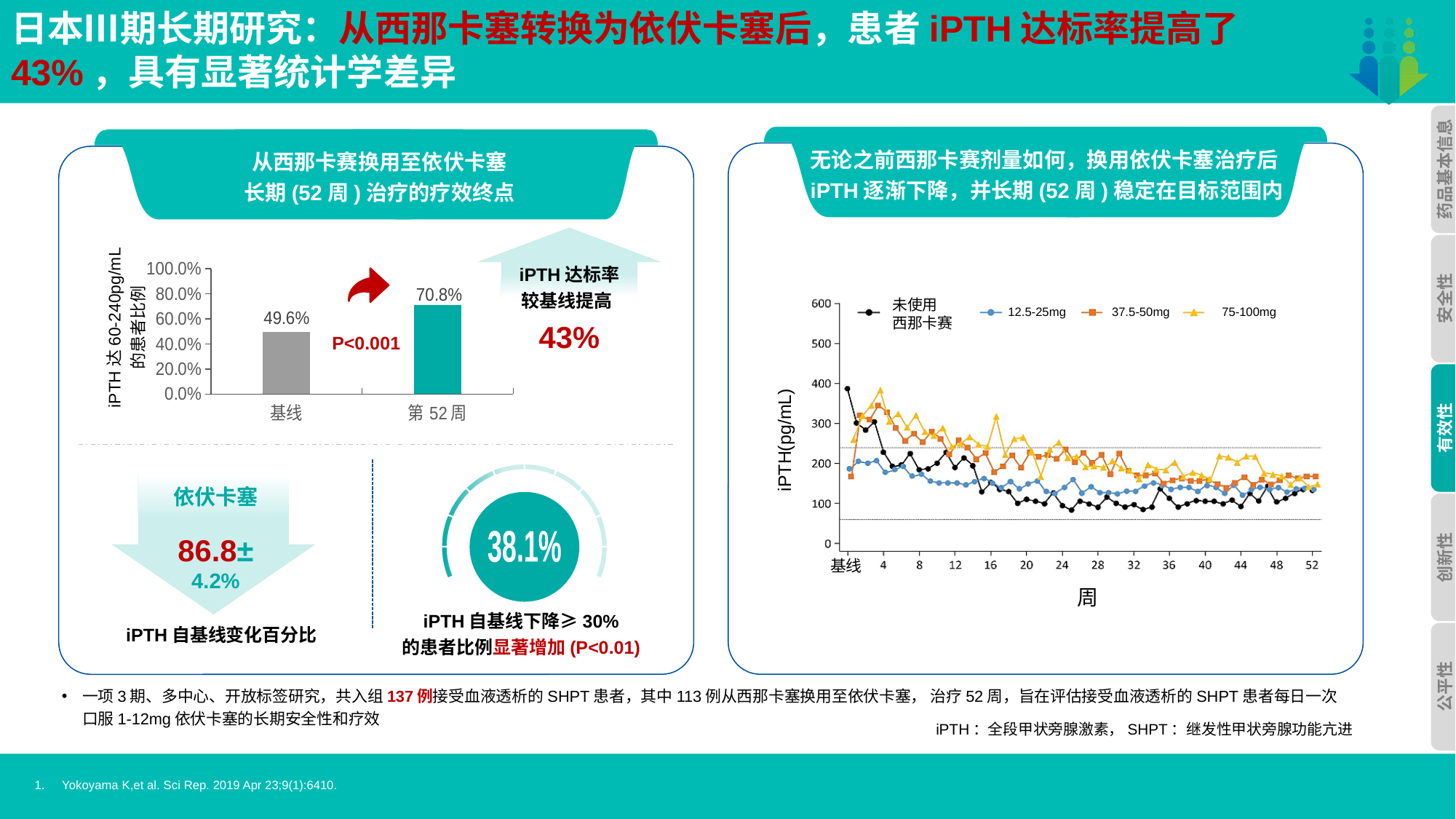
On the right line chart, how many series does the legend list? 4 On the left bar chart, what percentage of patients reached iPTH 60-240pg/mL at 第 52 周? 70.8% On the left bar chart, which category has the higher value, 基线 or 第 52 周? 第 52 周 What kind of chart is the chart on the left side of the slide? Bar chart On the right line chart, does the 未使用西那卡赛 series rise or fall from 基线 to week 52? Fall On the left bar chart, how many categories are shown on the x axis? 2 On the right line chart, is the value for 12.5-25mg at week 52 greater or less than 200? less On the right line chart, is the value for 未使用西那卡赛 at 基线 greater or less than 300? greater On the left bar chart, what P value is printed between the two bars? P<0.001 On the left bar chart, what percentage of patients reached iPTH 60-240pg/mL at 基线? 49.6% What kind of chart is the chart on the right side of the slide? Line chart On the left bar chart, what is the difference between the 第 52 周 value and the 基线 value? 21.2%